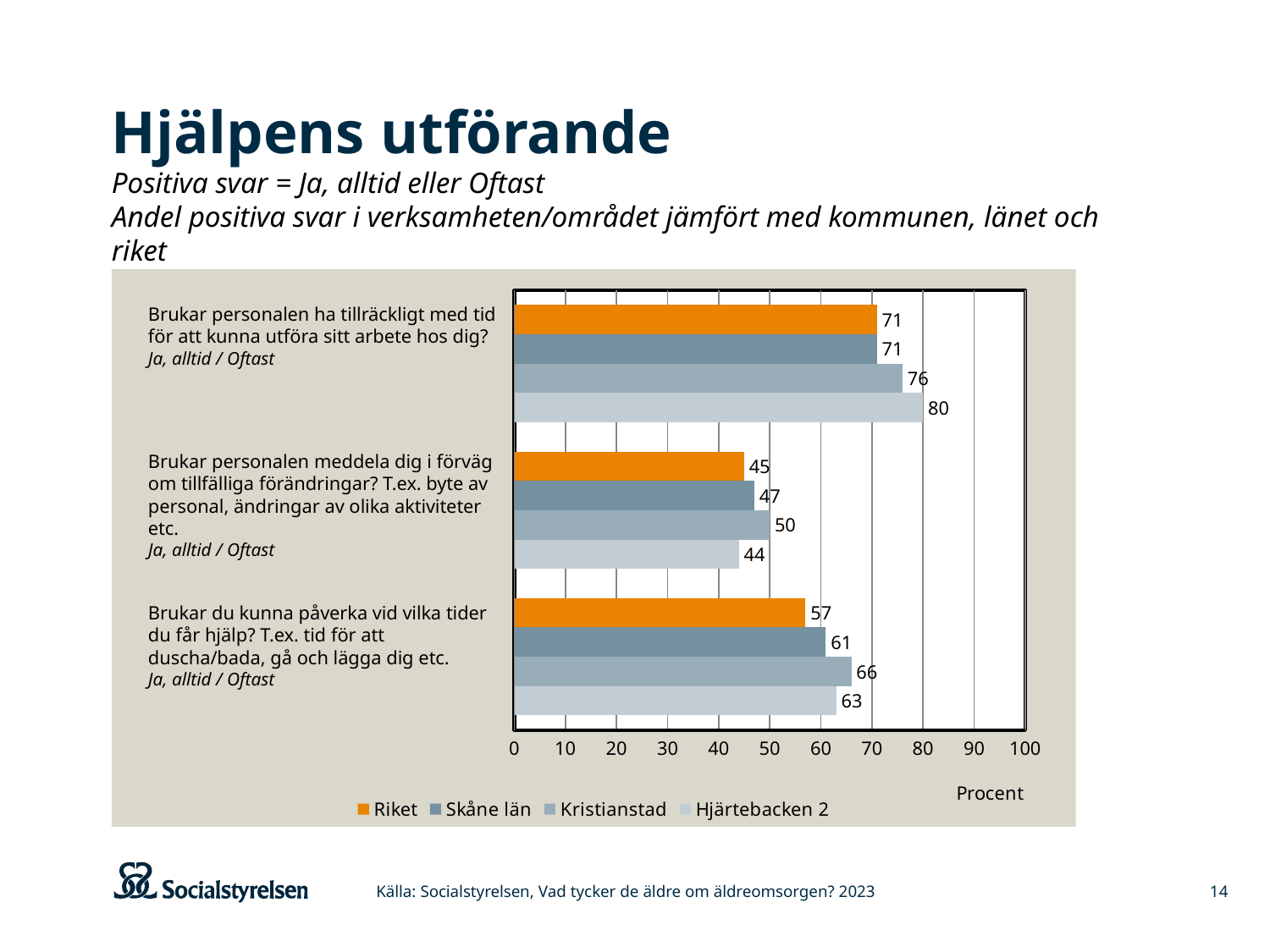
Which series has the highest value on the question "Brukar personalen ha tillräckligt med tid för att kunna utföra sitt arbete hos dig?" Hjärtebacken 2 Which is larger on the question "Brukar du kunna påverka vid vilka tider du får hjälp?": Kristianstad or Hjärtebacken 2? Kristianstad What is the difference between Hjärtebacken 2 and Riket on the question "Brukar personalen ha tillräckligt med tid för att kunna utföra sitt arbete hos dig?" 9 How many series does the legend list? 4 What kind of chart is shown on the slide? Bar chart Which series has the lowest value on the question "Brukar personalen meddela dig i förväg om tillfälliga förändringar?" Hjärtebacken 2 What is the value for Kristianstad on the question "Brukar du kunna påverka vid vilka tider du får hjälp?" 66 What is the value for Hjärtebacken 2 on the question "Brukar personalen ha tillräckligt med tid för att kunna utföra sitt arbete hos dig?" 80 What unit label is shown below the x axis of the chart? Procent Is the value for Hjärtebacken 2 on the question "Brukar personalen meddela dig i förväg om tillfälliga förändringar?" greater or less than 50? less What is the value for Riket on the question "Brukar personalen meddela dig i förväg om tillfälliga förändringar?" 45 What is the value for Skåne län on the question "Brukar du kunna påverka vid vilka tider du får hjälp?" 61